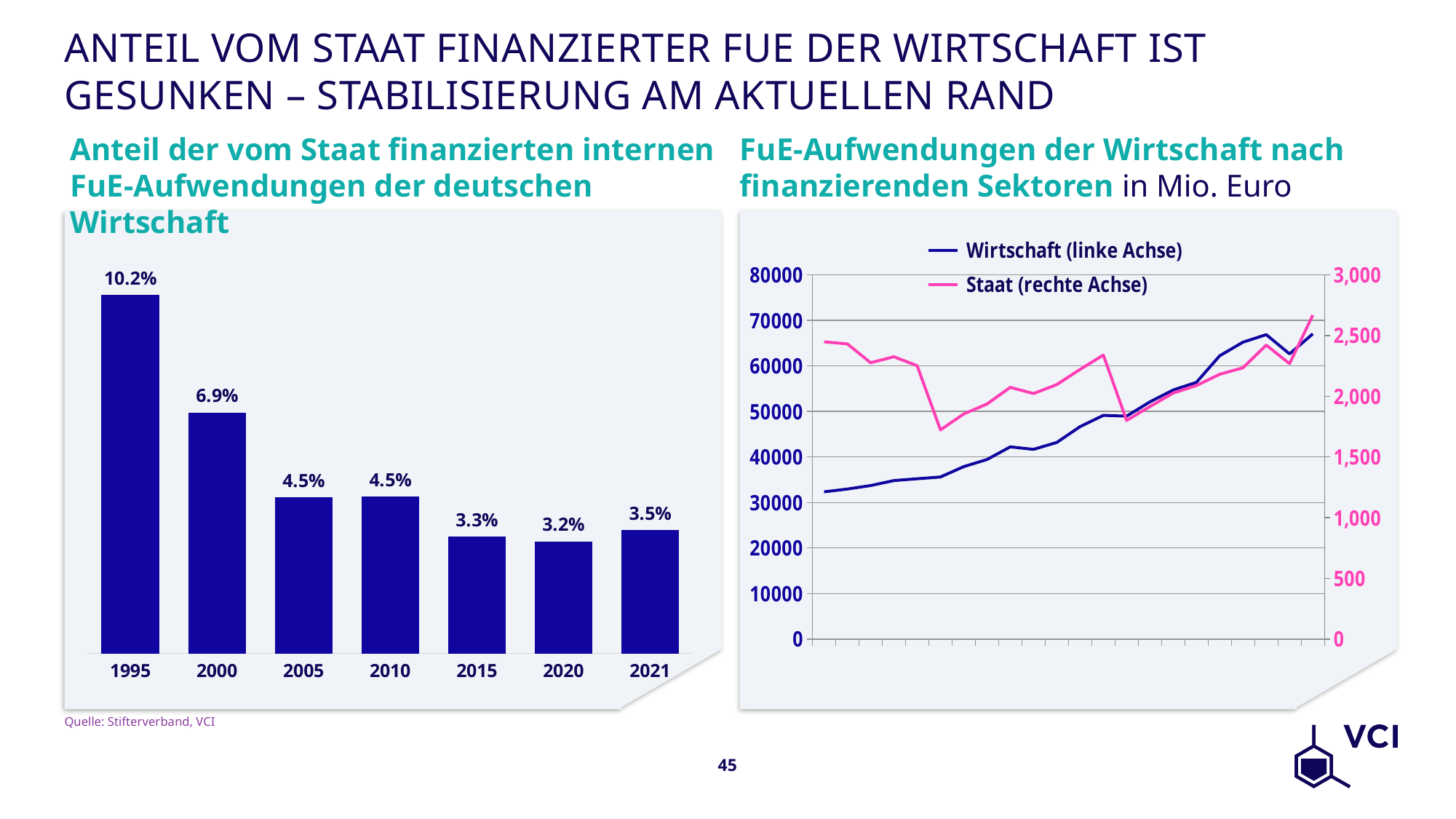
In the left chart, which year has the highest value? 1995 What kind of chart is the right chart? line chart In the left chart, what is the value for 2021? 3.5% What kind of chart is the left chart? bar chart How many series does the legend of the right chart list? 2 In the left chart, what is the value for 1995? 10.2% In the left chart, which is larger, the value for 2020 or the value for 2021? 2021 In the left chart, what is the difference between the values for 1995 and 2000? 3.3% In the right chart, does the Wirtschaft series generally rise or fall from left to right? rise In the left chart, what is the value for 2015? 3.3% In the left chart, which year has the lowest value? 2020 How many years are shown in the left chart? 7